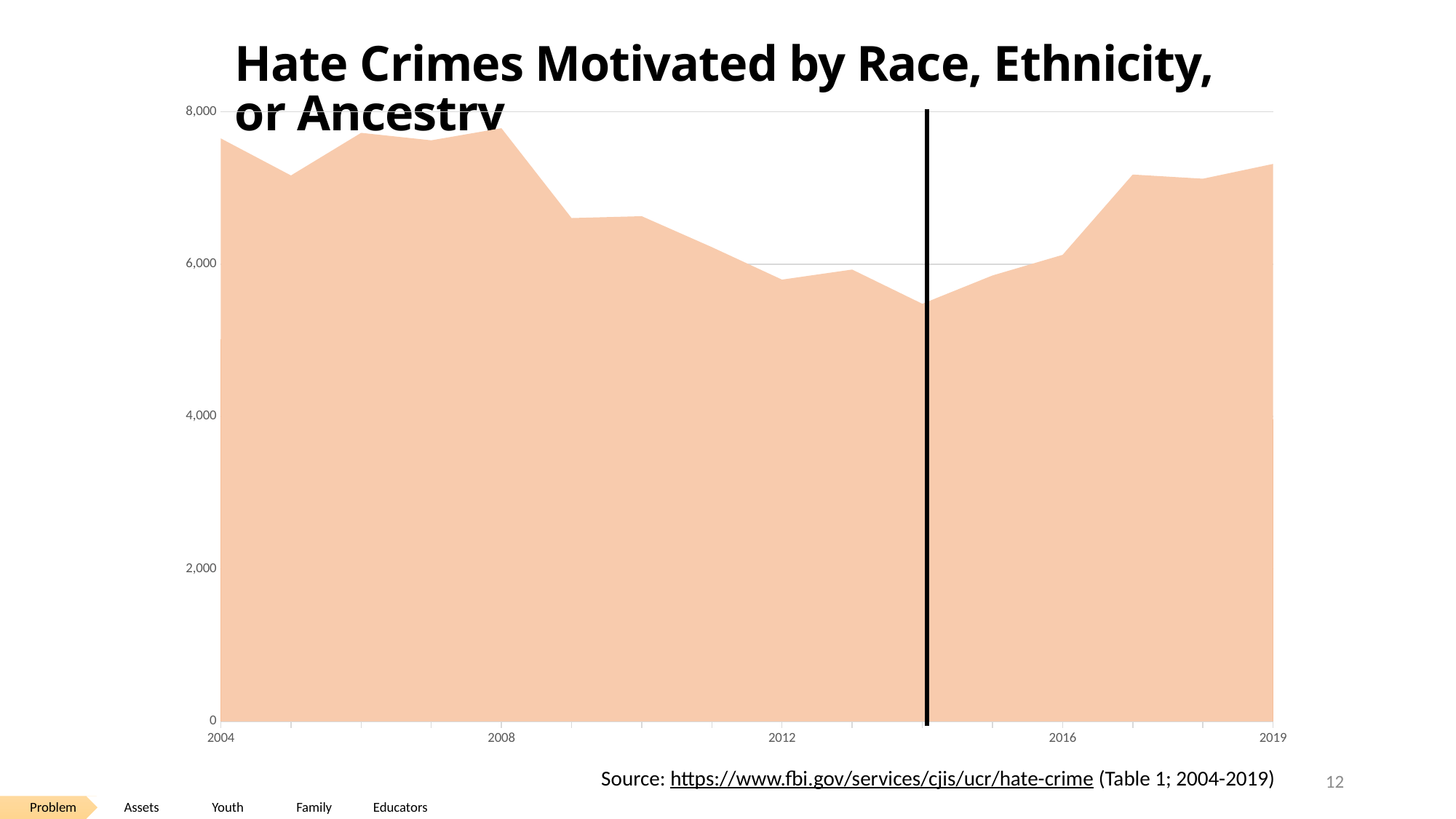
What is the first year shown on the x axis? 2004 Is the value for 2008 greater or less than 8,000? less Is the value for 2019 greater or less than 6,000? greater Is the value for 2004 greater or less than 6,000? greater Which year has the larger value, 2014 or 2019? 2019 Do the values rise or fall from 2014 to 2019? rise Which year has the lowest value on the chart? 2014 What is the title of the chart? Hate Crimes Motivated by Race, Ethnicity, or Ancestry What kind of chart is shown on the slide? area chart Do the values rise or fall from 2008 to 2014? fall Which year has the larger value, 2004 or 2012? 2004